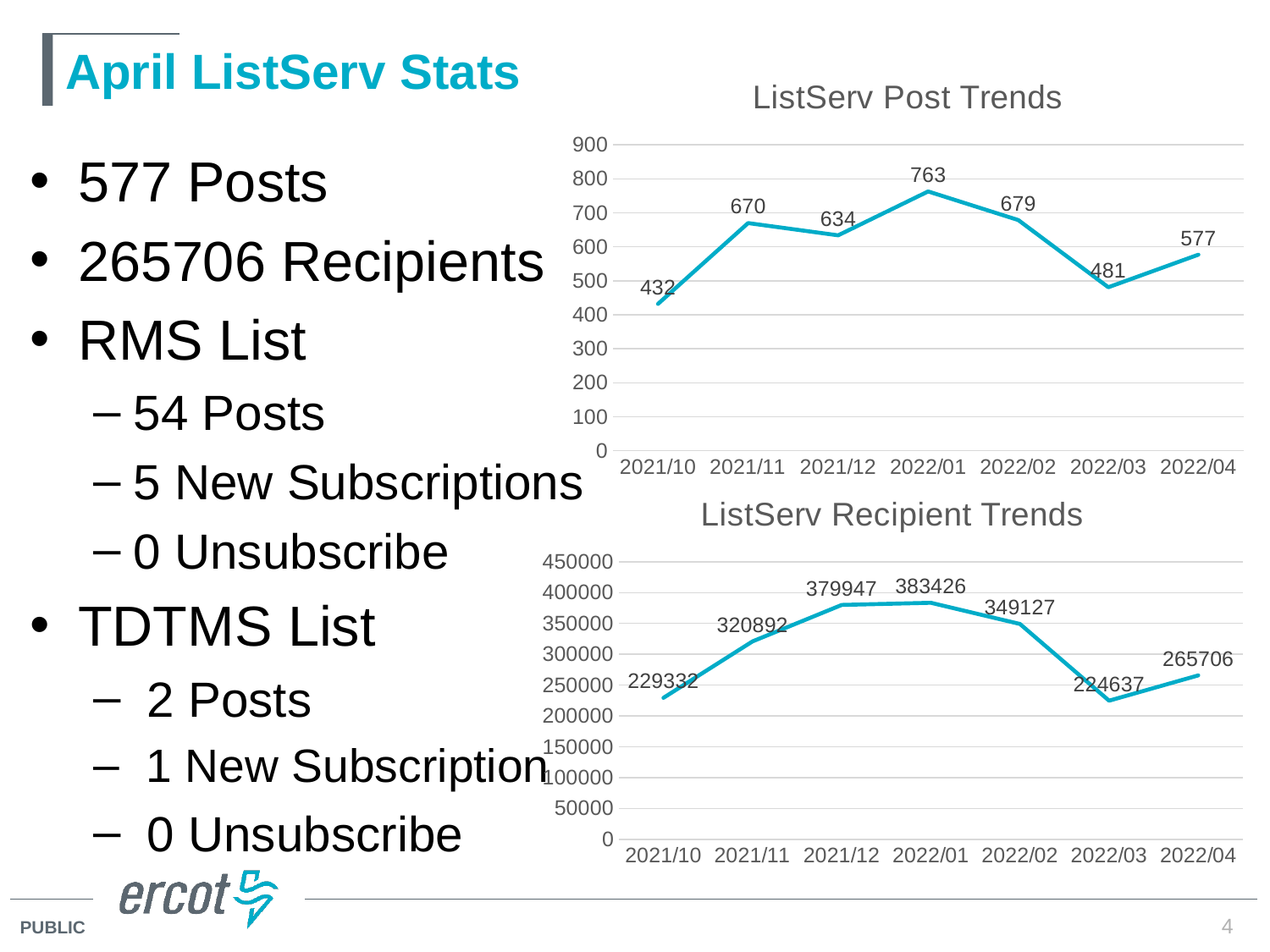
In the ListServ Recipient Trends chart, do the values rise or fall from 2022/01 to 2022/03? fall In the ListServ Post Trends chart, is the value for 2022/03 greater or less than 500? less In the ListServ Post Trends chart, what is the difference between the values for 2022/01 and 2022/04? 186 In the ListServ Recipient Trends chart, what is the value for 2022/02? 349127 In the ListServ Post Trends chart, which is larger, the value for 2021/11 or the value for 2021/12? 2021/11 In the ListServ Recipient Trends chart, which month has the lowest value? 2022/03 In the ListServ Recipient Trends chart, which month has the highest value? 2022/01 What kind of chart is the ListServ Post Trends chart? line chart In the ListServ Post Trends chart, what is the value for 2022/01? 763 In the ListServ Post Trends chart, which month has the lowest value? 2021/10 In the ListServ Recipient Trends chart, what is the difference between the values for 2022/04 and 2022/03? 41069 In the ListServ Post Trends chart, how many months are plotted? 7